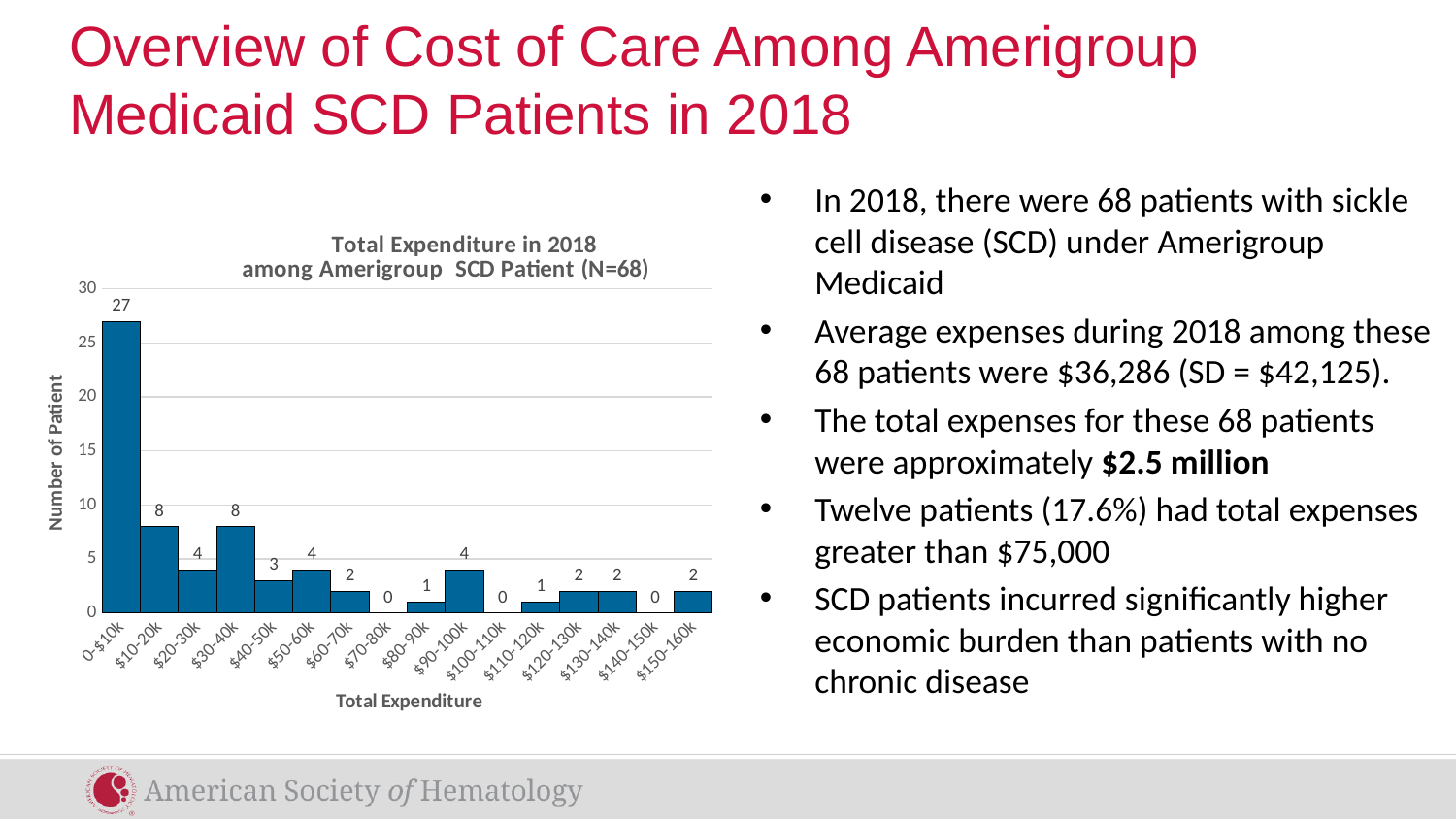
How many patients had total expenditure in the 0-$10k range? 27 How many patients fall in the $40-50k expenditure range? 3 Which has more patients, the $20-30k range or the $30-40k range? $30-40k Which expenditure range has the highest number of patients? 0-$10k What is the title of the chart? Total Expenditure in 2018 among Amerigroup SCD Patient (N=68) What is the number of patients in the $90-100k expenditure range? 4 What type of chart is used to show the total expenditure distribution? Bar chart Is the value for the 0-$10k range greater or less than 25? greater How many expenditure ranges are shown on the x axis? 16 How many expenditure ranges have 0 patients? 3 What is the difference in number of patients between the 0-$10k range and the $10-20k range? 19 What is the label of the y axis of the chart? Number of Patient